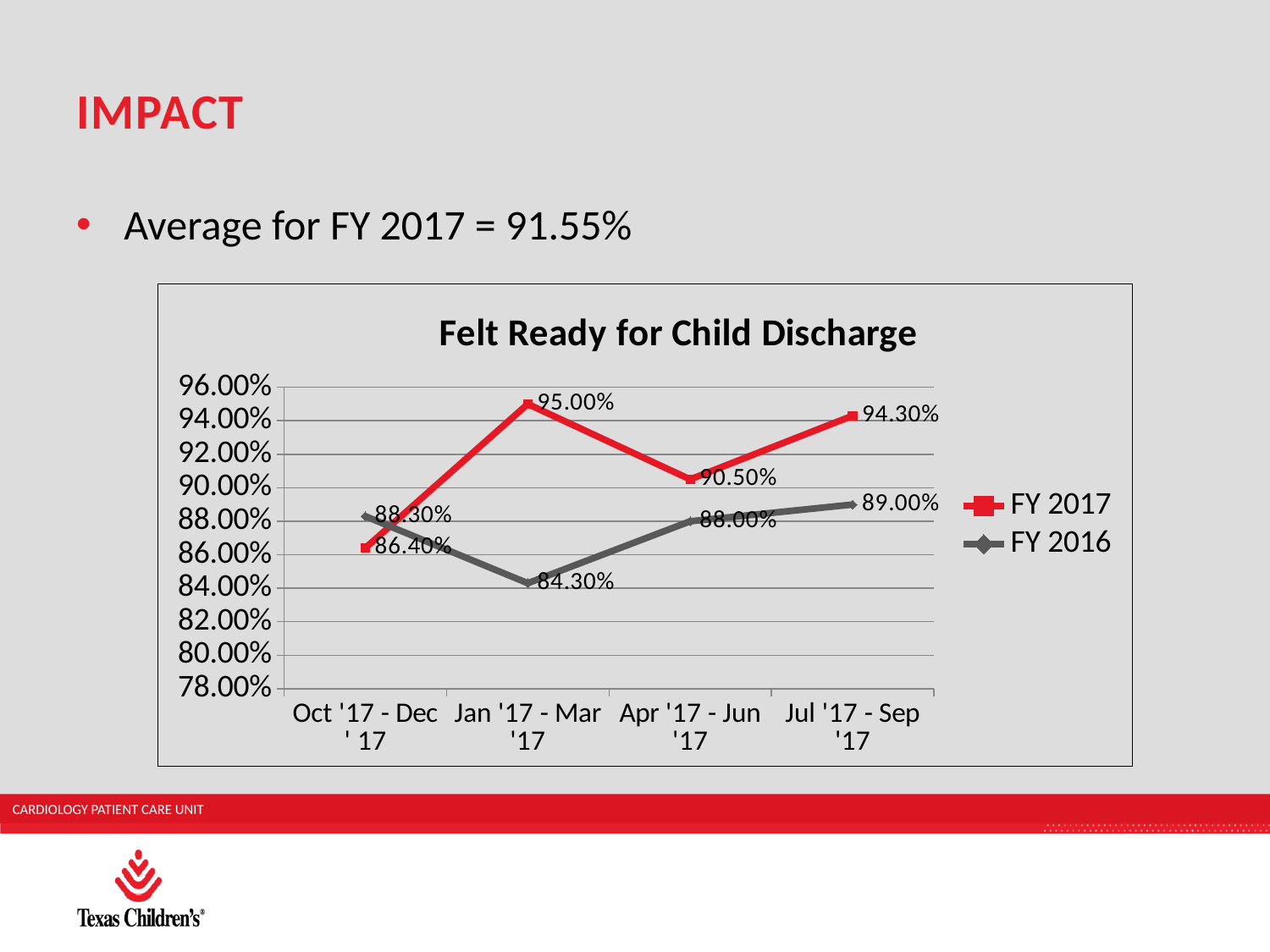
How many series does the legend list? 2 What is the FY 2017 value for Oct '17 - Dec '17? 86.40% What type of chart is shown on the slide? Line chart How many quarters are plotted along the x axis? 4 What is the difference between the FY 2017 and FY 2016 values for Jan '17 - Mar '17? 10.70% What is the title of the chart? Felt Ready for Child Discharge Which series has the larger value for Oct '17 - Dec '17, FY 2017 or FY 2016? FY 2016 In which quarter is the FY 2017 value highest? Jan '17 - Mar '17 What is the FY 2016 value for Jul '17 - Sep '17? 89.00% What is the FY 2017 value for Jan '17 - Mar '17? 95.00% Does the FY 2016 line rise or fall from Apr '17 - Jun '17 to Jul '17 - Sep '17? Rise In which quarter is the FY 2016 value lowest? Jan '17 - Mar '17